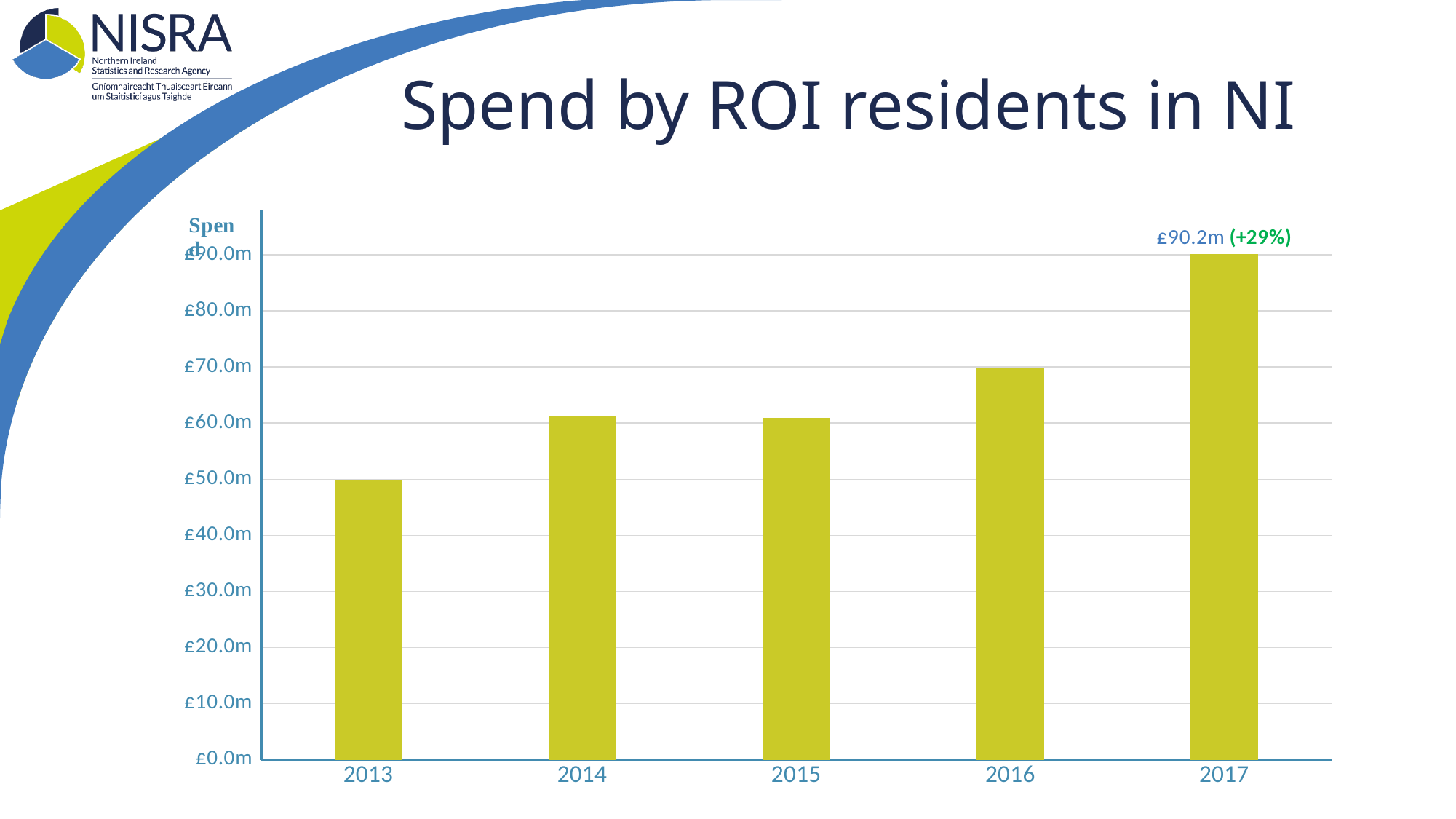
Which year has the larger spend, 2016 or 2013? 2016 What percentage change is shown next to the 2017 bar? +29% What kind of chart is shown on the slide? bar chart What is the title of the chart? Spend by ROI residents in NI Which year has the highest spend? 2017 Is the value for 2016 greater or less than £60.0m? greater How many years are shown on the x axis of the chart? 5 Is the value for 2013 greater or less than £60.0m? less What is the spend value labelled for 2017? £90.2m Which year has the lowest spend? 2013 Do the values generally rise or fall from 2013 to 2017? rise Is the value for 2014 greater or less than £50.0m? greater